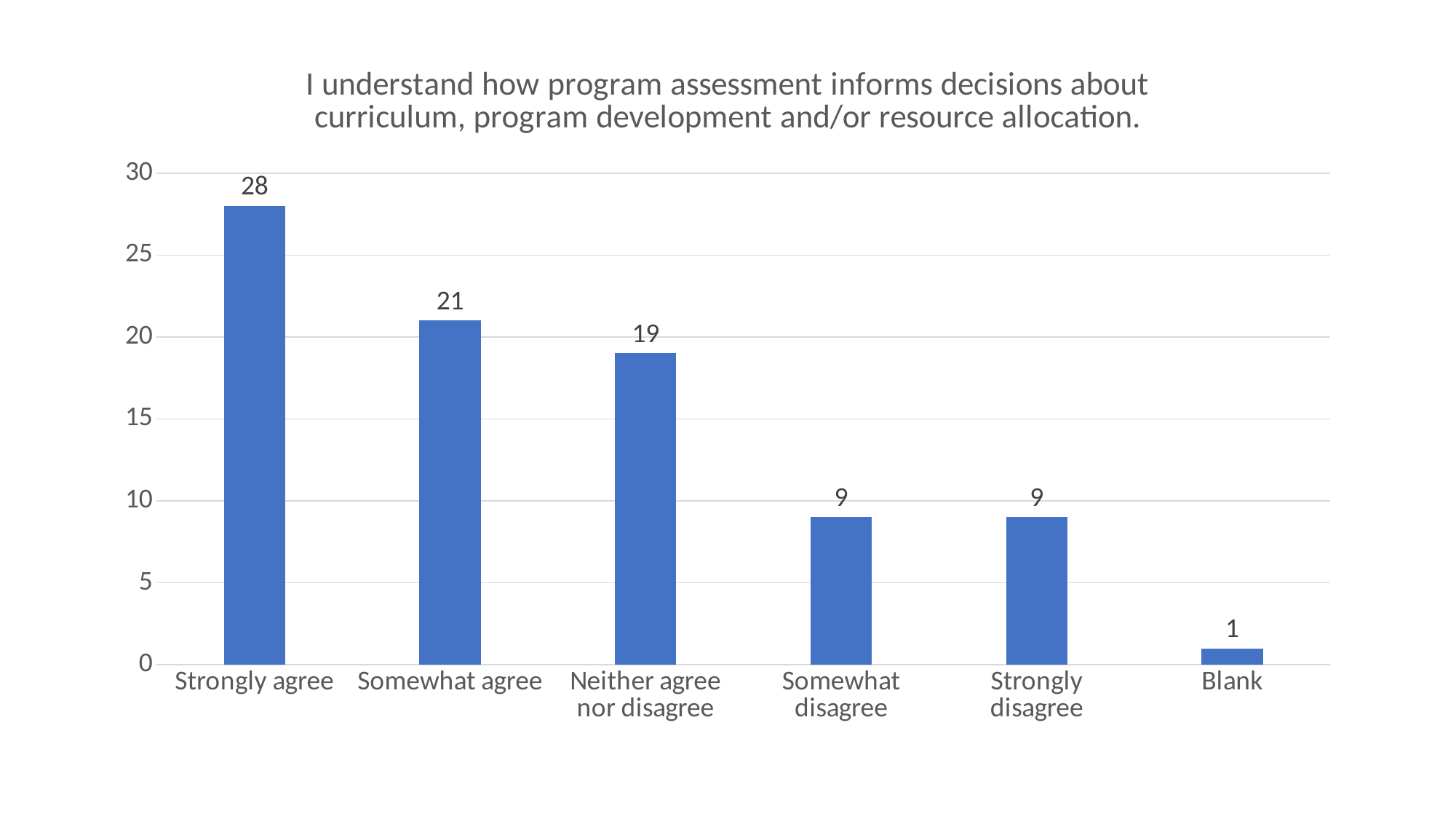
Which is larger, Somewhat agree or Neither agree nor disagree? Somewhat agree What is the difference between Strongly agree and Somewhat agree? 7 Which category has the highest value? Strongly agree What is the title of the chart? I understand how program assessment informs decisions about curriculum, program development and/or resource allocation. What is the value for Strongly agree? 28 How many categories are shown on the x axis? 6 What is the value for Blank? 1 What kind of chart is this? bar chart Which category has the lowest value? Blank Is the value for Neither agree nor disagree greater or less than 15? greater What is the value for Neither agree nor disagree? 19 What is the difference between Somewhat agree and Somewhat disagree? 12